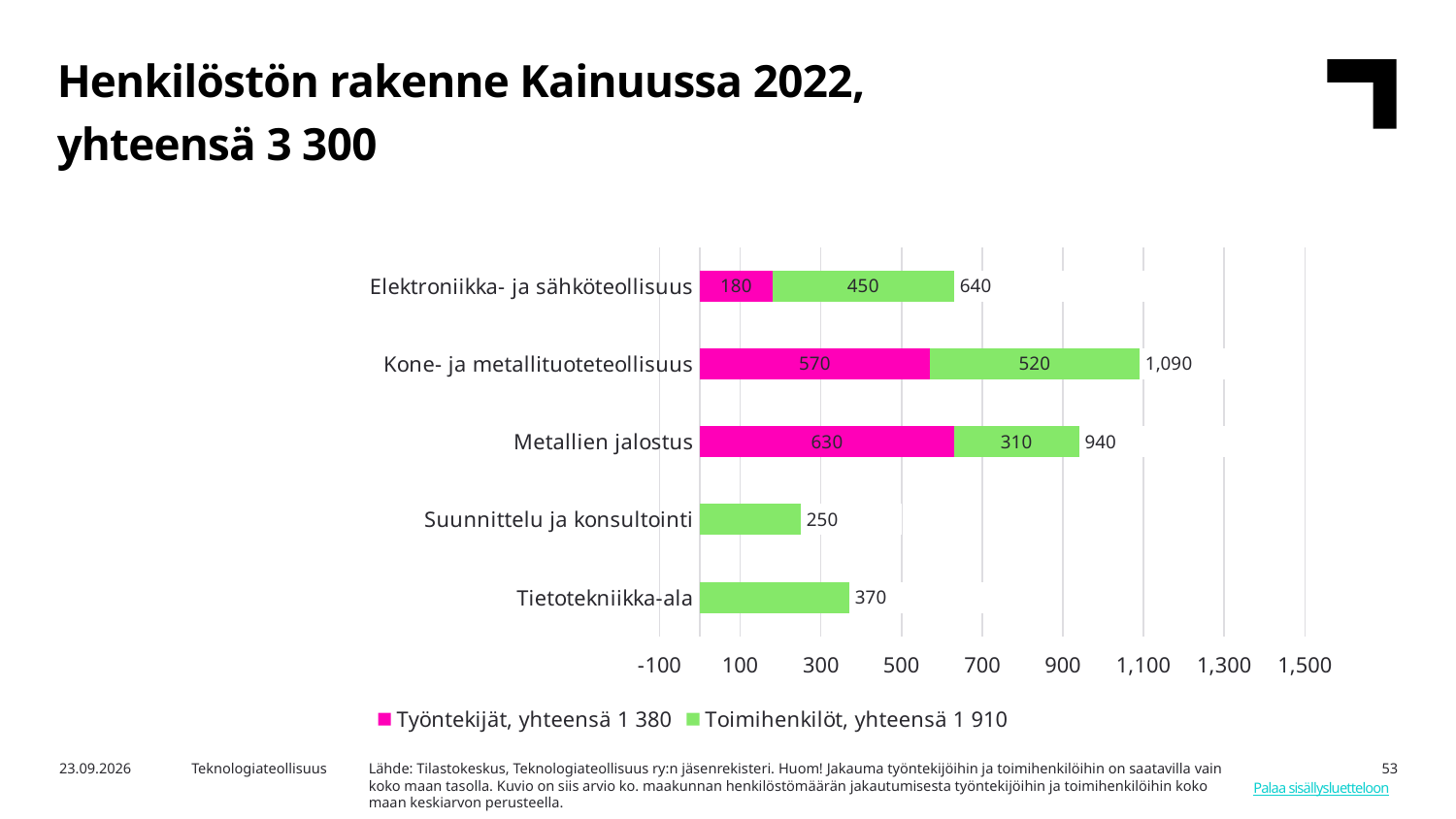
How many categories are shown on the chart? 5 Which category has the highest total? Kone- ja metallituoteteollisuus Which category has the lowest total? Suunnittelu ja konsultointi What is the Työntekijät value for Kone- ja metallituoteteollisuus? 570 What type of chart is shown on the slide? Stacked bar chart What is the title of the chart on the slide? Henkilöstön rakenne Kainuussa 2022, yhteensä 3 300 What is the Toimihenkilöt value for Elektroniikka- ja sähköteollisuus? 450 How many series does the legend list? 2 What total is given for Toimihenkilöt in the legend? 1 910 Which is larger, the Toimihenkilöt value for Tietotekniikka-ala or for Suunnittelu ja konsultointi? Tietotekniikka-ala What is the total shown for Metallien jalostus? 940 What is the difference between the Työntekijät values for Metallien jalostus and Elektroniikka- ja sähköteollisuus? 450